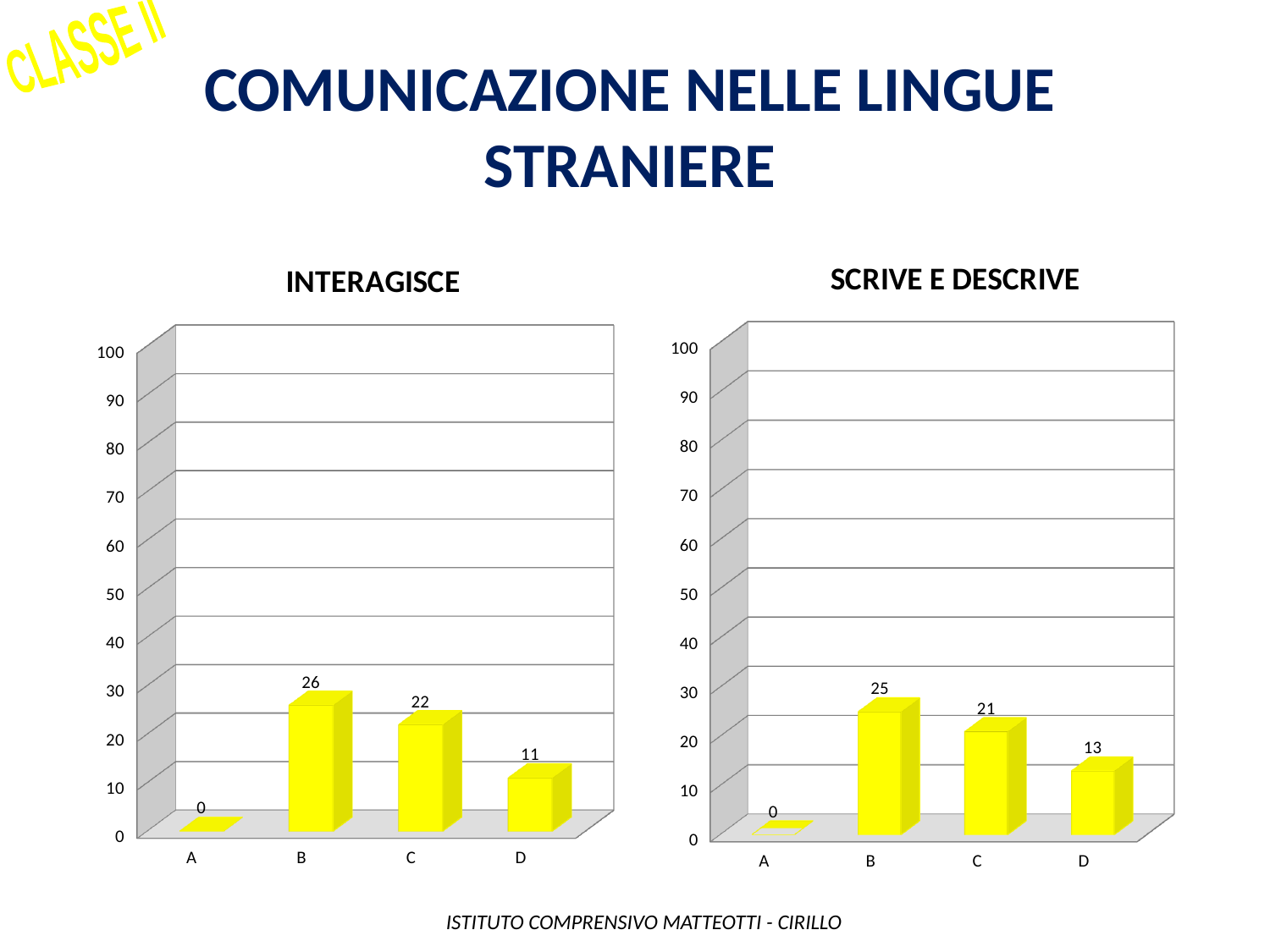
In the SCRIVE E DESCRIVE chart, which category has the lowest value? A What kind of chart is the SCRIVE E DESCRIVE chart? bar chart What is the title of the chart on the left of the slide? INTERAGISCE In the INTERAGISCE chart, what is the difference between the values for B and D? 15 In the SCRIVE E DESCRIVE chart, what is the difference between the values for B and C? 4 In the INTERAGISCE chart, is the value for C greater or less than 30? less In the INTERAGISCE chart, what is the value for category B? 26 In the SCRIVE E DESCRIVE chart, what is the value for category A? 0 How many categories are shown in the INTERAGISCE chart? 4 In the INTERAGISCE chart, which category has the highest value? B In the SCRIVE E DESCRIVE chart, what is the value for category D? 13 In the SCRIVE E DESCRIVE chart, which is larger, the value for C or the value for D? C